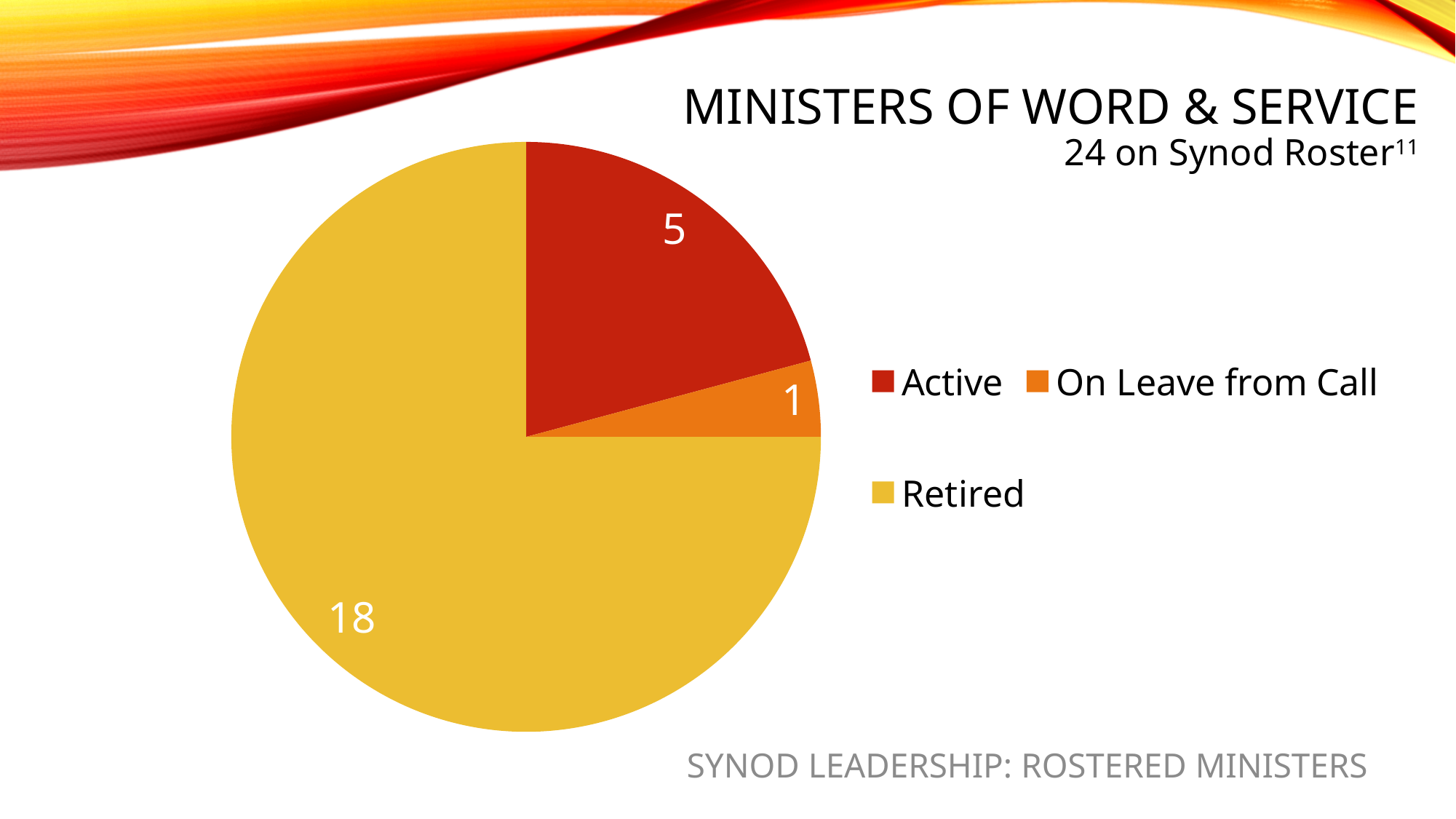
Which category has the smallest slice of the pie? On Leave from Call What kind of chart is shown on the slide? pie chart Which is larger, the Active slice or the On Leave from Call slice? Active Which category has the largest slice of the pie? Retired How many ministers are Retired? 18 How many ministers are On Leave from Call? 1 What share of the pie does the Retired slice represent? 75% How many categories does the pie chart show? 3 How many ministers are Active? 5 What is the total of all slices in the pie chart? 24 What is the difference between the number of Retired ministers and the number of Active ministers? 13 What colour is the Retired slice in the pie chart? yellow